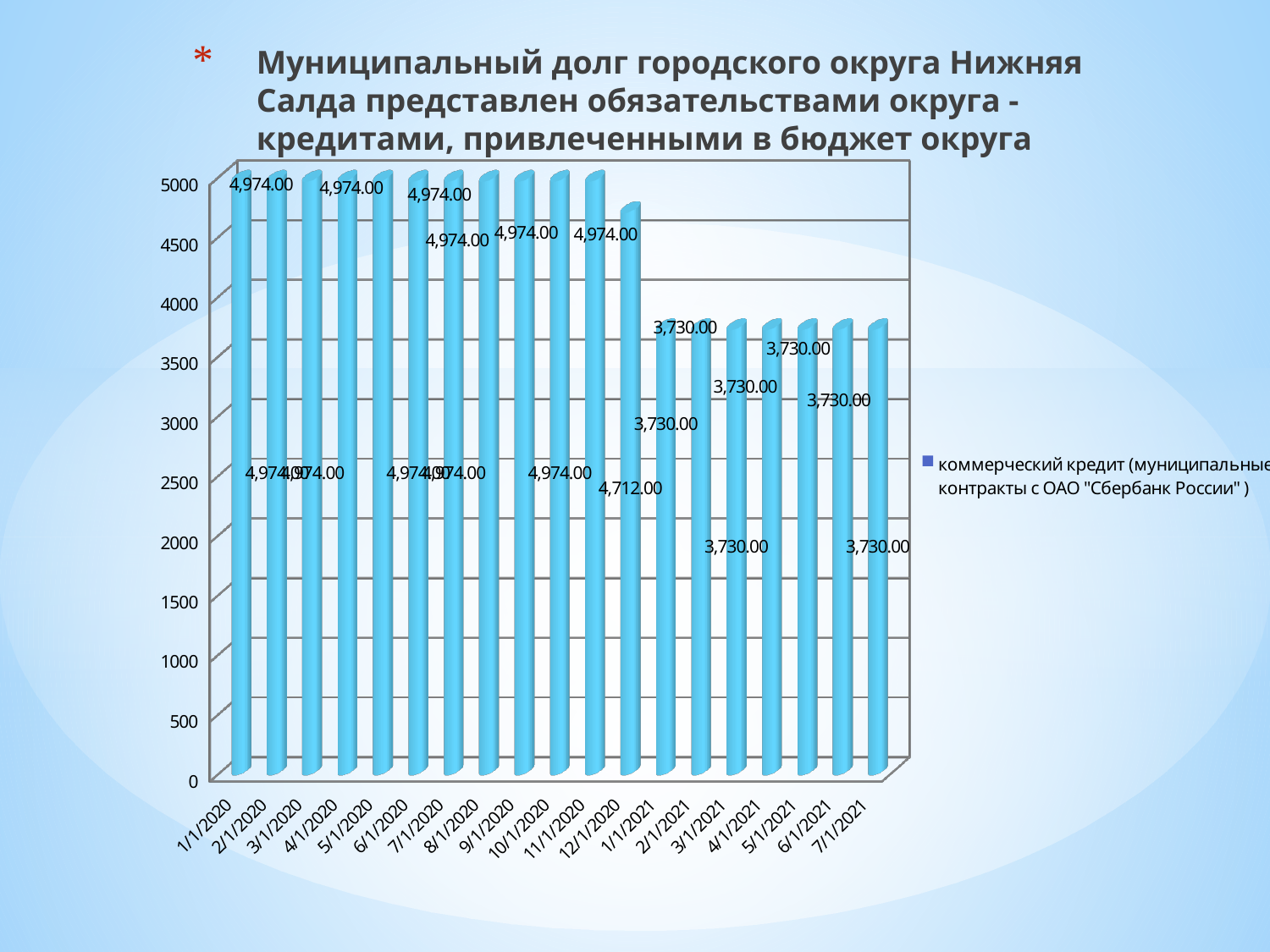
What is the value for 1/1/2020? 4,974.00 What is the difference between the value for 11/1/2020 and the value for 12/1/2020? 262.00 How many series does the legend list? 1 Which is larger, the value for 11/1/2020 or the value for 1/1/2021? 11/1/2020 Is the value for 12/1/2020 greater or less than 4500? greater What is the value for 12/1/2020? 4,712.00 What kind of chart is shown on the slide? bar chart How many dates are shown on the x axis? 19 What is the lowest value shown on the chart? 3,730.00 What is the value for 7/1/2021? 3,730.00 What is the difference between the value for 1/1/2020 and the value for 1/1/2021? 1,244.00 What is the highest value shown on the chart? 4,974.00